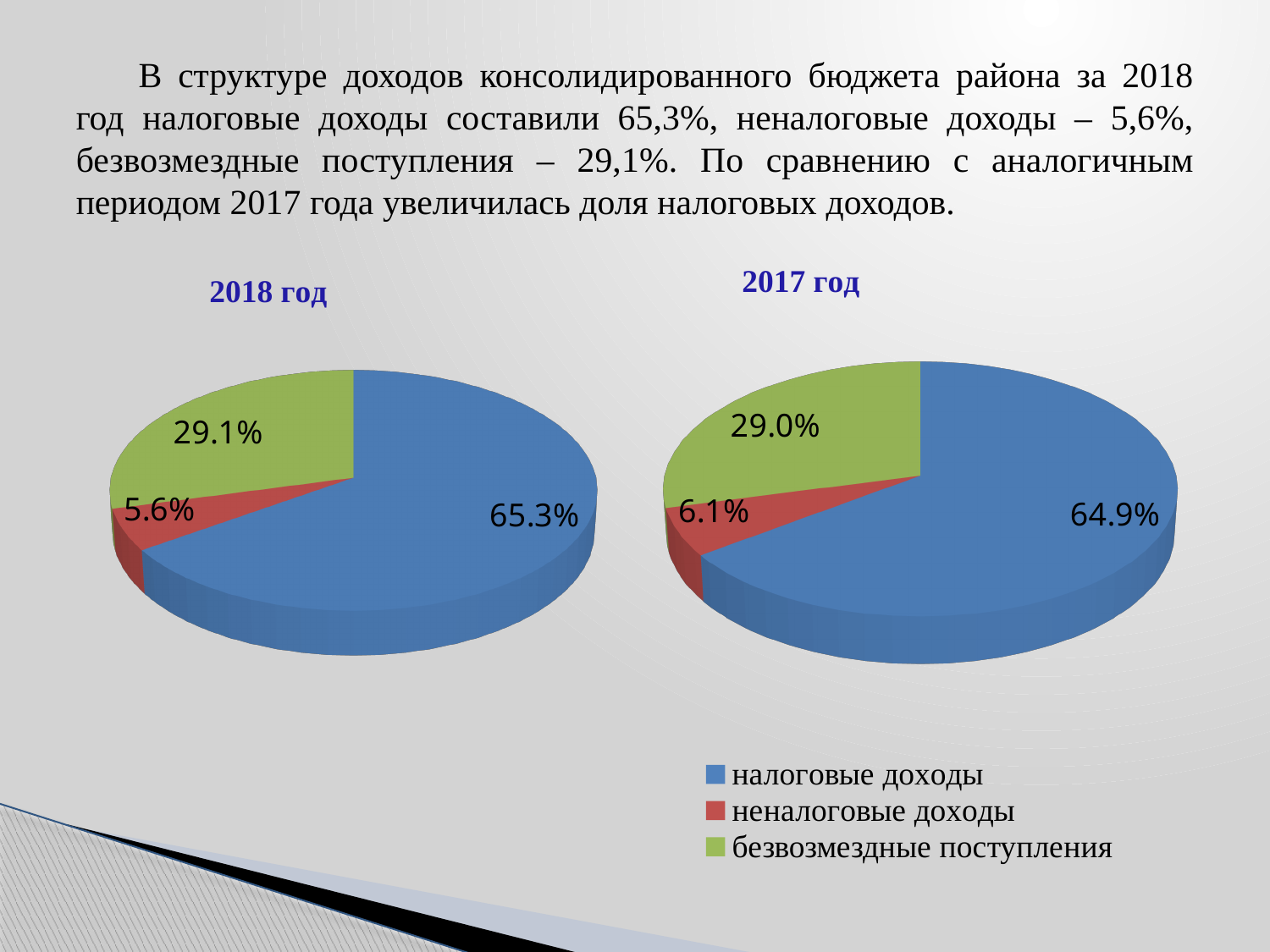
In the "2017 год" chart, what share is shown for неналоговые доходы? 6.1% How many slices does the "2018 год" chart have? 3 In the "2017 год" chart, what share is shown for безвозмездные поступления? 29.0% What type of chart is the "2017 год" chart? pie chart In the "2018 год" chart, what share is shown for неналоговые доходы? 5.6% Is the share of безвозмездные поступления larger in the "2018 год" chart or the "2017 год" chart? 2018 год In the "2017 год" chart, which category has the smallest slice? неналоговые доходы In the "2018 год" chart, what share is shown for налоговые доходы? 65.3% What colour represents безвозмездные поступления in the charts? green What is the difference between the share of налоговые доходы in the "2018 год" chart and in the "2017 год" chart? 0.4% How many entries does the legend list? 3 In the "2018 год" chart, which category has the largest slice? налоговые доходы